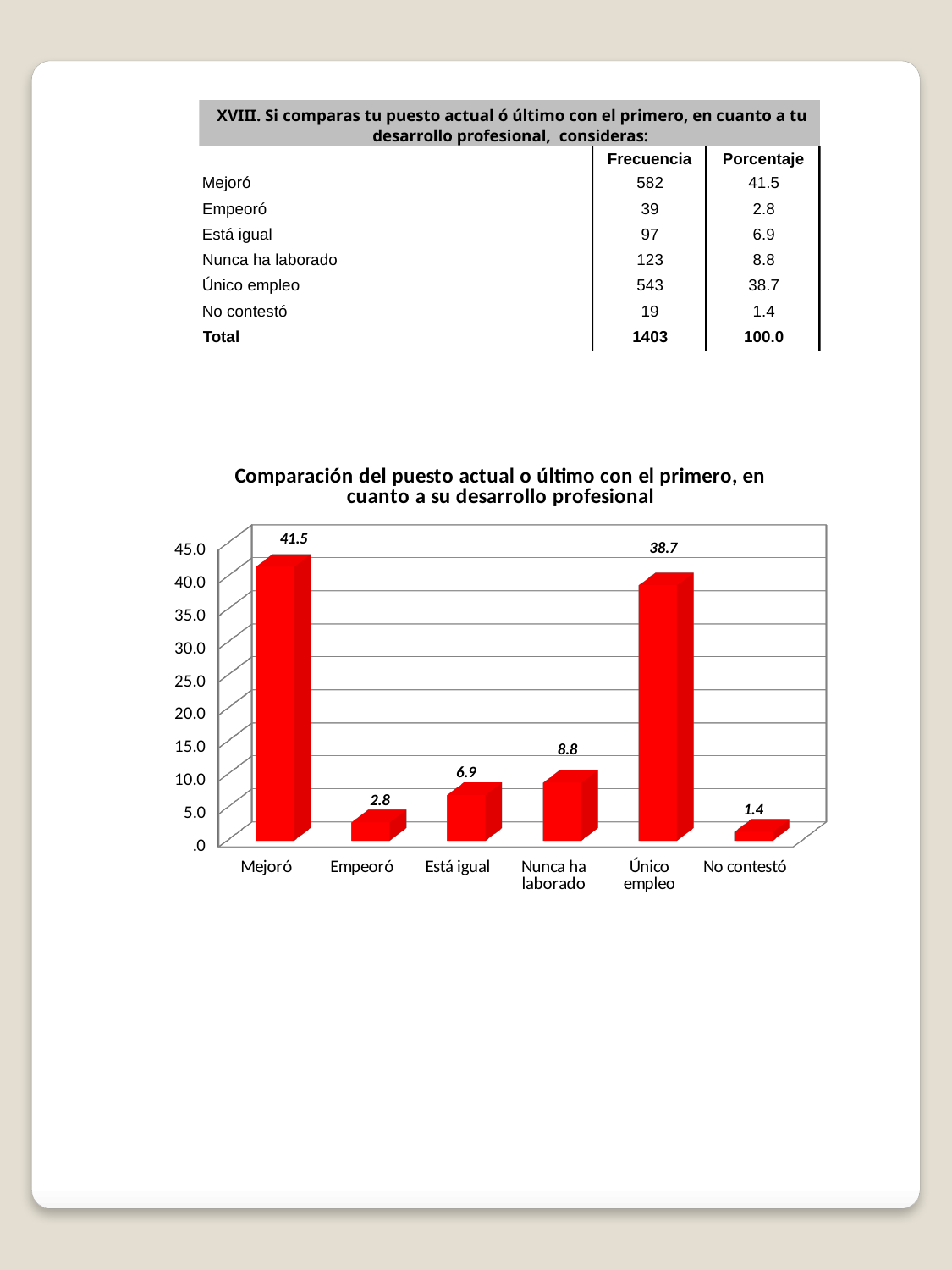
What colour are the bars in the chart? red What is the value for Mejoró in the chart? 41.5 What kind of chart is shown on the slide? bar chart Which category has the highest value in the chart? Mejoró What is the value for Único empleo in the chart? 38.7 Is the value for Único empleo greater or less than 35.0? greater What is the difference between the values for Nunca ha laborado and Está igual? 1.9 What is the value for Nunca ha laborado in the chart? 8.8 What is the difference between the values for Mejoró and Único empleo? 2.8 How many categories are shown on the x axis of the chart? 6 Which is larger, the value for Está igual or the value for Empeoró? Está igual Which category has the lowest value in the chart? No contestó